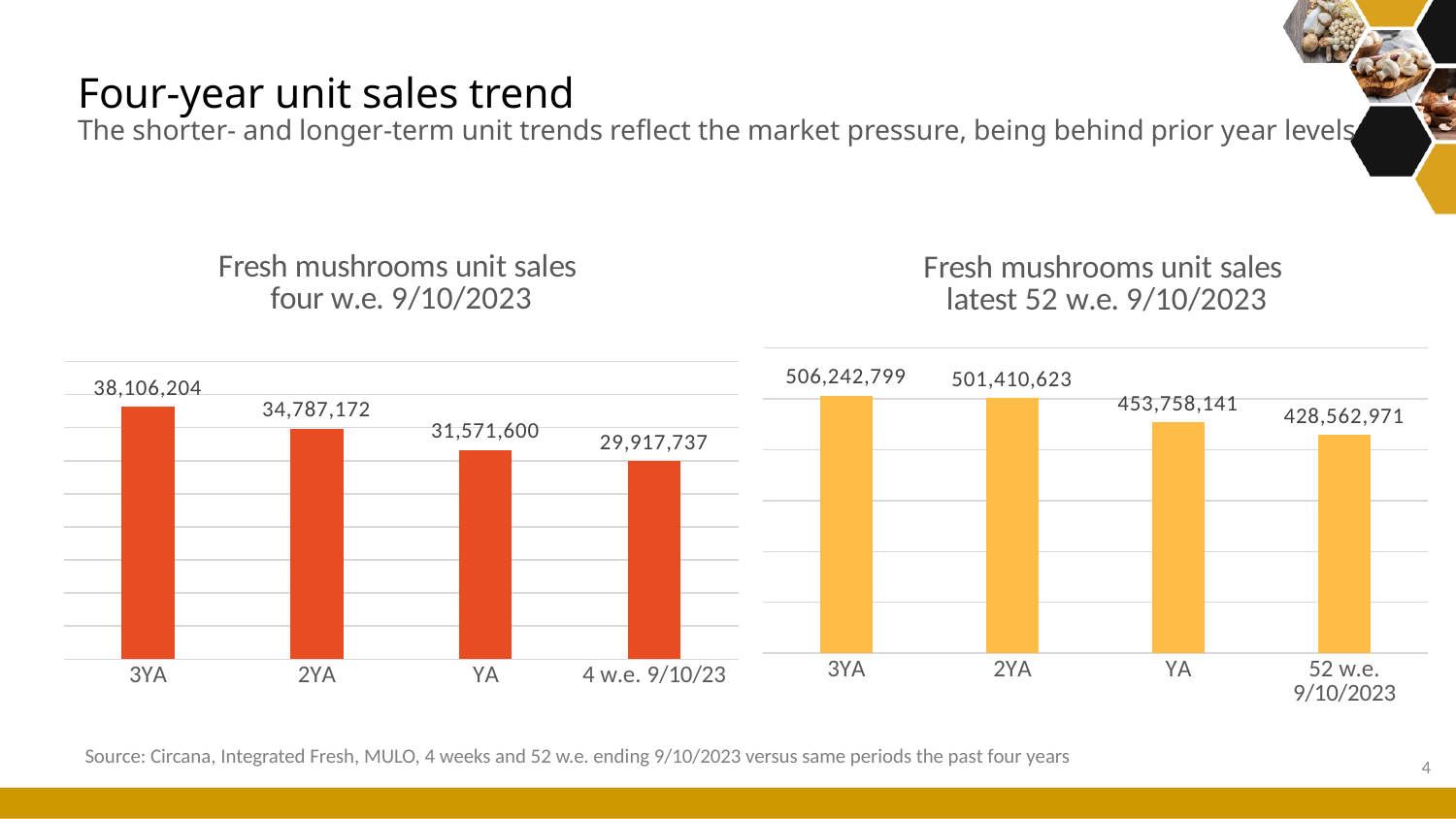
In the 'Fresh mushrooms unit sales latest 52 w.e. 9/10/2023' chart, do the values rise or fall from 3YA to 52 w.e. 9/10/2023? Fall How many bars are shown in the 'Fresh mushrooms unit sales latest 52 w.e. 9/10/2023' chart? 4 In the 'Fresh mushrooms unit sales four w.e. 9/10/2023' chart, what is the value for 3YA? 38,106,204 In the 'Fresh mushrooms unit sales four w.e. 9/10/2023' chart, which is larger, the value for 2YA or the value for YA? 2YA What kind of chart is the 'Fresh mushrooms unit sales four w.e. 9/10/2023' chart? Bar chart In the 'Fresh mushrooms unit sales four w.e. 9/10/2023' chart, which category has the highest value? 3YA In the 'Fresh mushrooms unit sales latest 52 w.e. 9/10/2023' chart, what is the difference between the YA value and the 52 w.e. 9/10/2023 value? 25,195,170 In the 'Fresh mushrooms unit sales latest 52 w.e. 9/10/2023' chart, what is the value for YA? 453,758,141 In the 'Fresh mushrooms unit sales four w.e. 9/10/2023' chart, what is the difference between the 3YA value and the 4 w.e. 9/10/23 value? 8,188,467 In the 'Fresh mushrooms unit sales latest 52 w.e. 9/10/2023' chart, what is the value for 52 w.e. 9/10/2023? 428,562,971 In the 'Fresh mushrooms unit sales four w.e. 9/10/2023' chart, what is the value for 4 w.e. 9/10/23? 29,917,737 In the 'Fresh mushrooms unit sales latest 52 w.e. 9/10/2023' chart, which category has the lowest value? 52 w.e. 9/10/2023